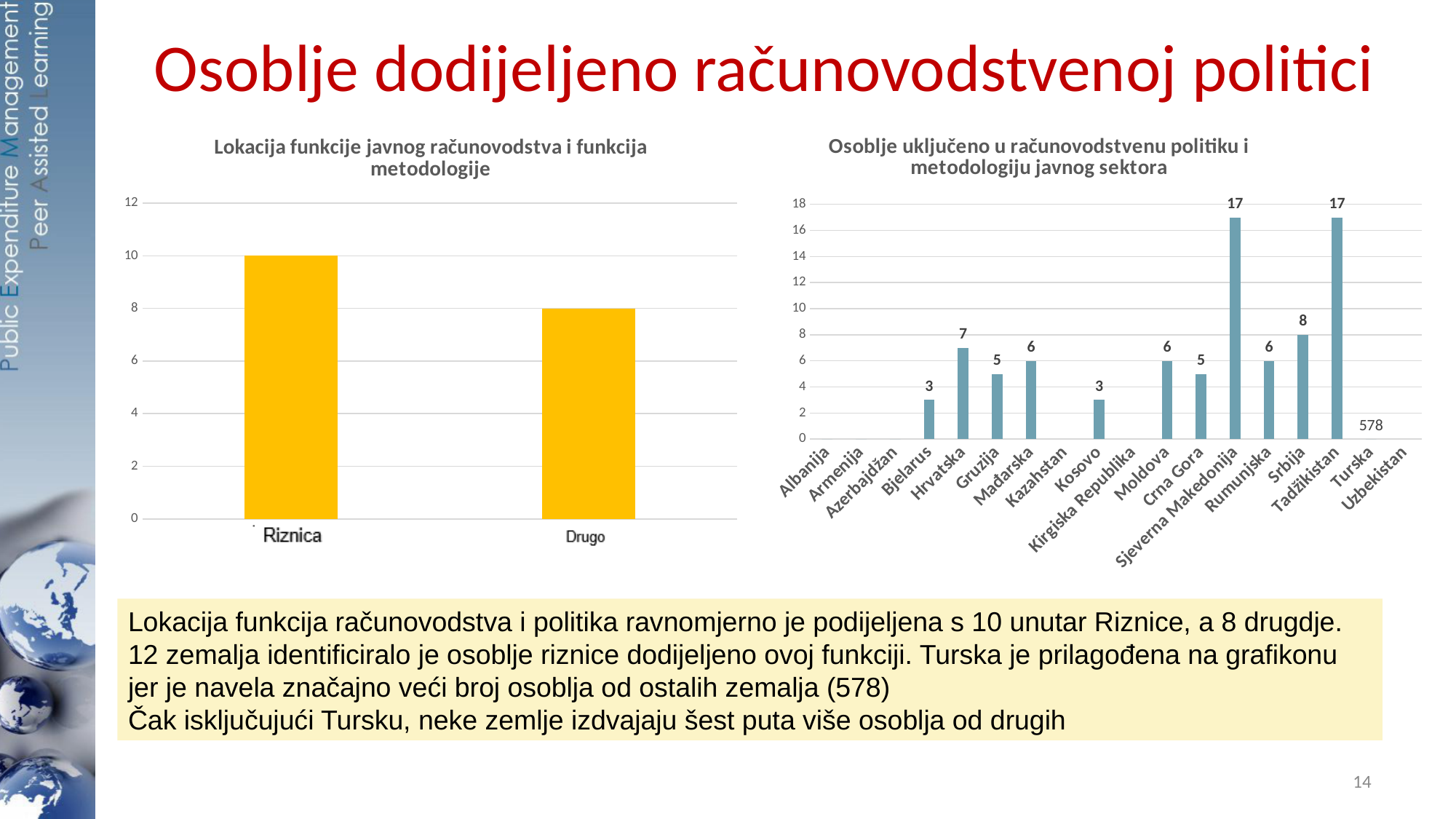
In the right chart (Osoblje uključeno u računovodstvenu politiku i metodologiju javnog sektora), what is the value for Tadžikistan? 17 In the left chart (Lokacija funkcije javnog računovodstva i funkcija metodologije), which is larger, Riznica or Drugo? Riznica In the right chart (Osoblje uključeno u računovodstvenu politiku i metodologiju javnog sektora), what value is labelled for Turska? 578 In the right chart (Osoblje uključeno u računovodstvenu politiku i metodologiju javnog sektora), what is the value for Hrvatska? 7 In the right chart (Osoblje uključeno u računovodstvenu politiku i metodologiju javnog sektora), what is the difference between Srbija and Gruzija? 3 In the left chart (Lokacija funkcije javnog računovodstva i funkcija metodologije), what is the difference between Riznica and Drugo? 2 What kind of chart is the left chart (Lokacija funkcije javnog računovodstva i funkcija metodologije)? Bar chart In the left chart (Lokacija funkcije javnog računovodstva i funkcija metodologije), what is the value for Drugo? 8 How many countries are listed on the x axis of the right chart (Osoblje uključeno u računovodstvenu politiku i metodologiju javnog sektora)? 18 In the right chart (Osoblje uključeno u računovodstvenu politiku i metodologiju javnog sektora), which is larger, Mađarska or Crna Gora? Mađarska In the left chart (Lokacija funkcije javnog računovodstva i funkcija metodologije), what is the value for Riznica? 10 How many categories are shown in the left chart (Lokacija funkcije javnog računovodstva i funkcija metodologije)? 2